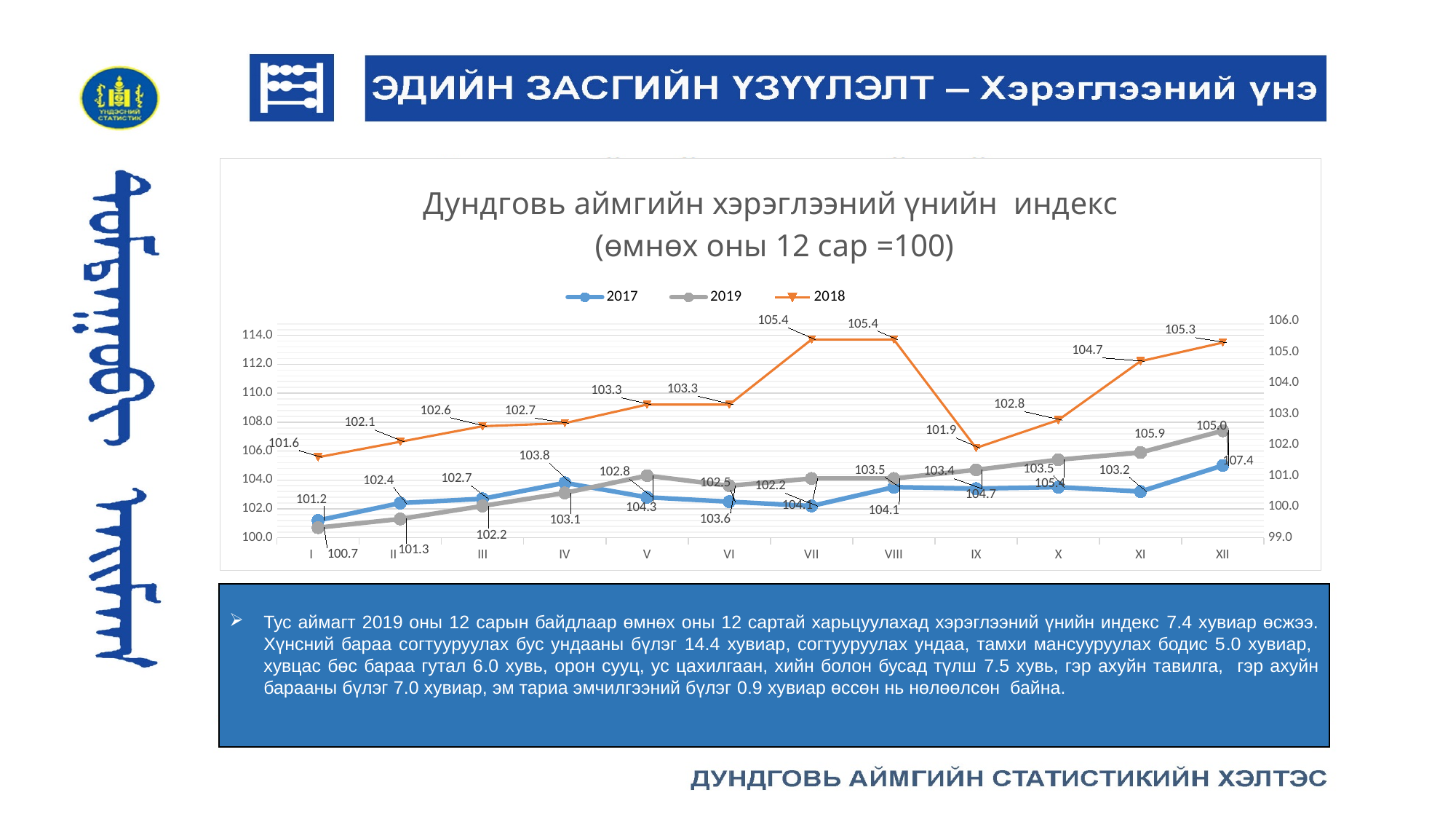
Which is larger for the 2018 series: the value in month VII or in month IX? Month VII What is the difference between the 2018 values in month XII and month I? 3.7 What is the value of the 2017 series in month I? 101.2 What is the value of the 2018 series in month XI? 104.7 What is the value of the 2019 series in month I? 100.7 What is the value of the 2018 series in month IX? 101.9 How many months (categories) are plotted along the x axis? 12 Does the 2019 series generally rise or fall from month I to month XII? Rise What type of chart is shown on the slide? Line chart How many series does the legend list? 3 In which month is the 2018 series at its lowest value? I What is the value of the 2018 series in month VII? 105.4